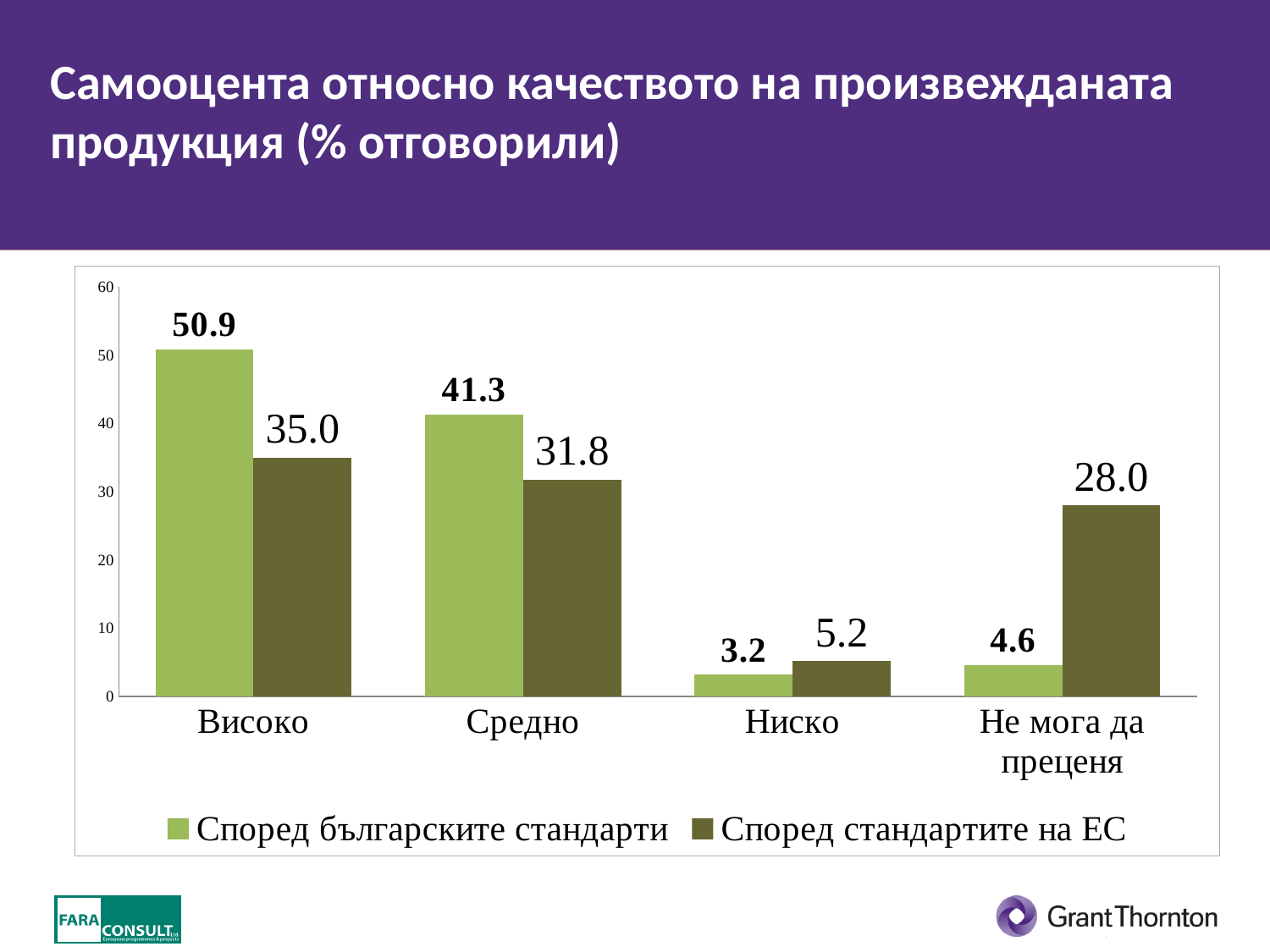
For Ниско, which series has the larger value? Според стандартите на ЕС How many series does the legend list? 2 How many categories are shown on the x axis? 4 Which category has the lowest value in the Според стандартите на ЕС series? Ниско Which category has the highest value in the Според българските стандарти series? Високо What is the value for Средно in the Според стандартите на ЕС series? 31.8 What is the value for Високо in the Според българските стандарти series? 50.9 What is the difference between the two series for Високо? 15.9 What is the maximum value shown on the vertical axis? 60 Is the value for Средно in the Според българските стандарти series greater or less than 40? greater What kind of chart is shown on the slide? bar chart What is the value for Не мога да преценя in the Според стандартите на ЕС series? 28.0